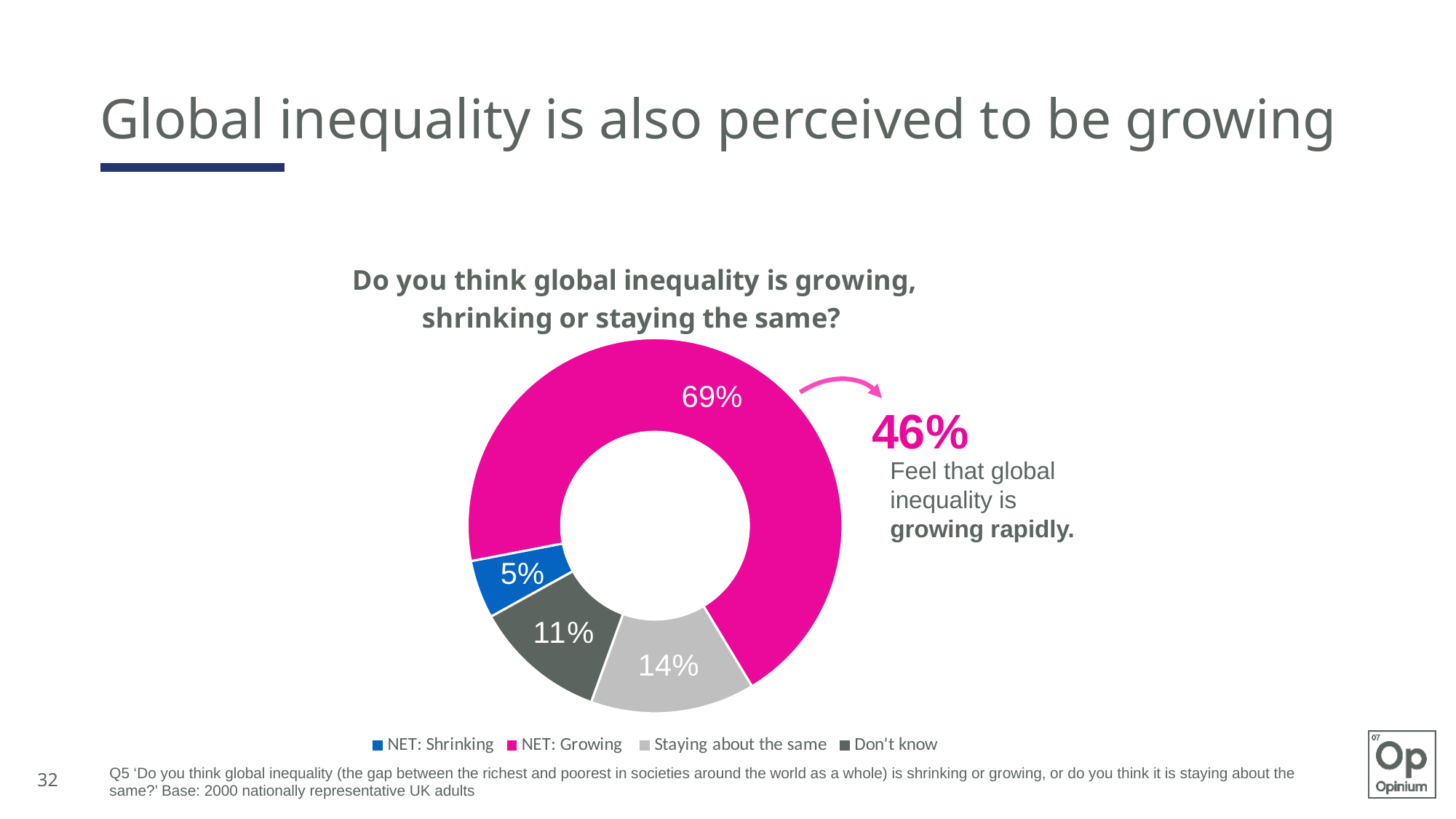
Which category has the smallest share of the chart? NET: Shrinking What colour is the NET: Shrinking segment in the chart? Blue What is the difference in percentage points between NET: Growing and Staying about the same? 55 What percentage of respondents said Staying about the same? 14% What percentage of respondents said Don't know? 11% What kind of chart is shown on the slide? Doughnut chart Which is larger, the share for Don't know or the share for Staying about the same? Staying about the same What percentage of respondents said NET: Shrinking? 5% What percentage of respondents said NET: Growing? 69% How many categories are shown in the chart? 4 What is the title of the chart? Do you think global inequality is growing, shrinking or staying the same? Which category has the largest share of the chart? NET: Growing